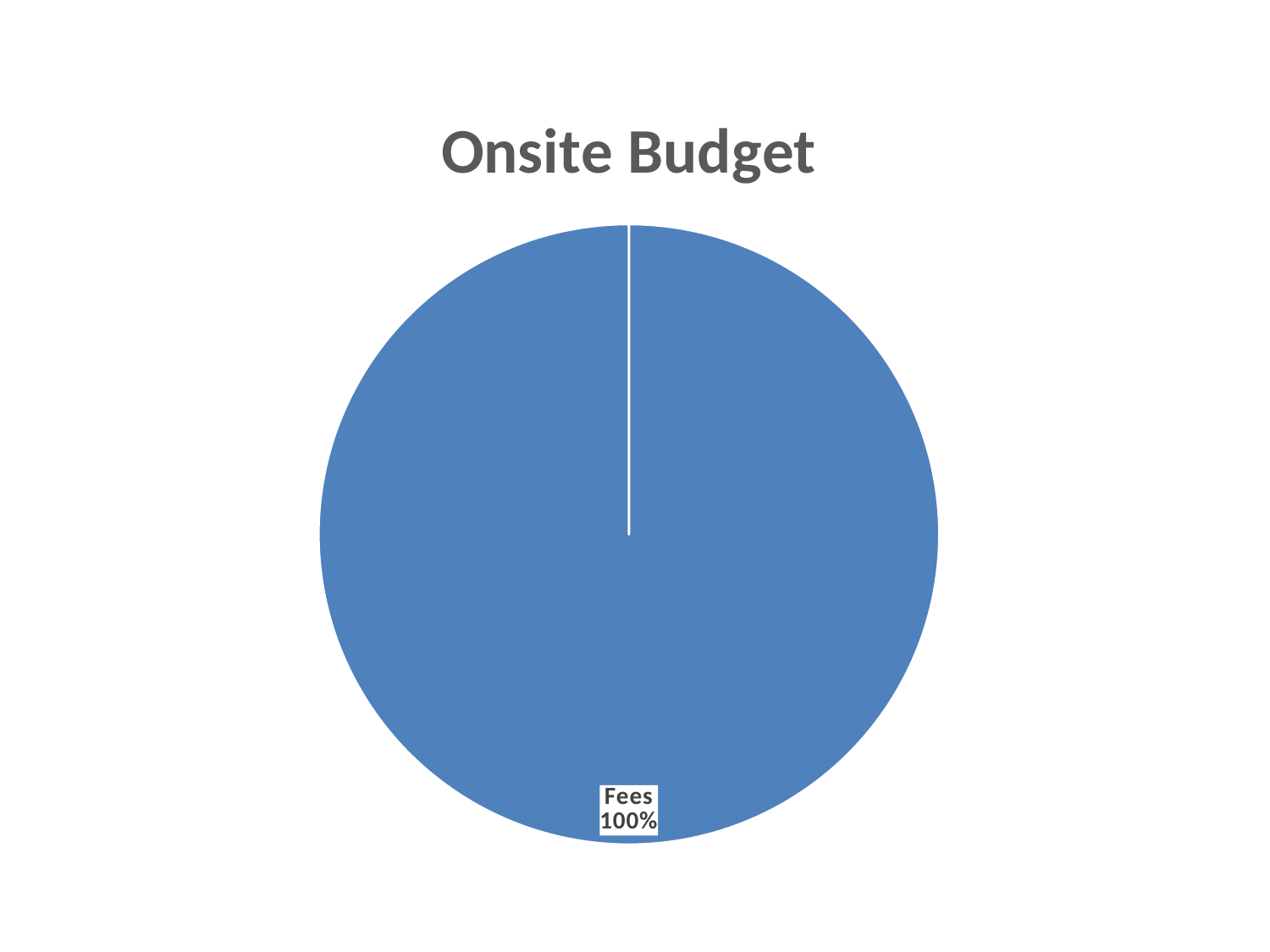
Which category is labelled on the pie chart? Fees What share of the pie does Fees account for? 100% What kind of chart is shown on the slide? pie chart What is the title of the chart? Onsite Budget What colour is the Fees slice? blue Which category has the largest share of the pie? Fees How many slices does the pie chart have? 1